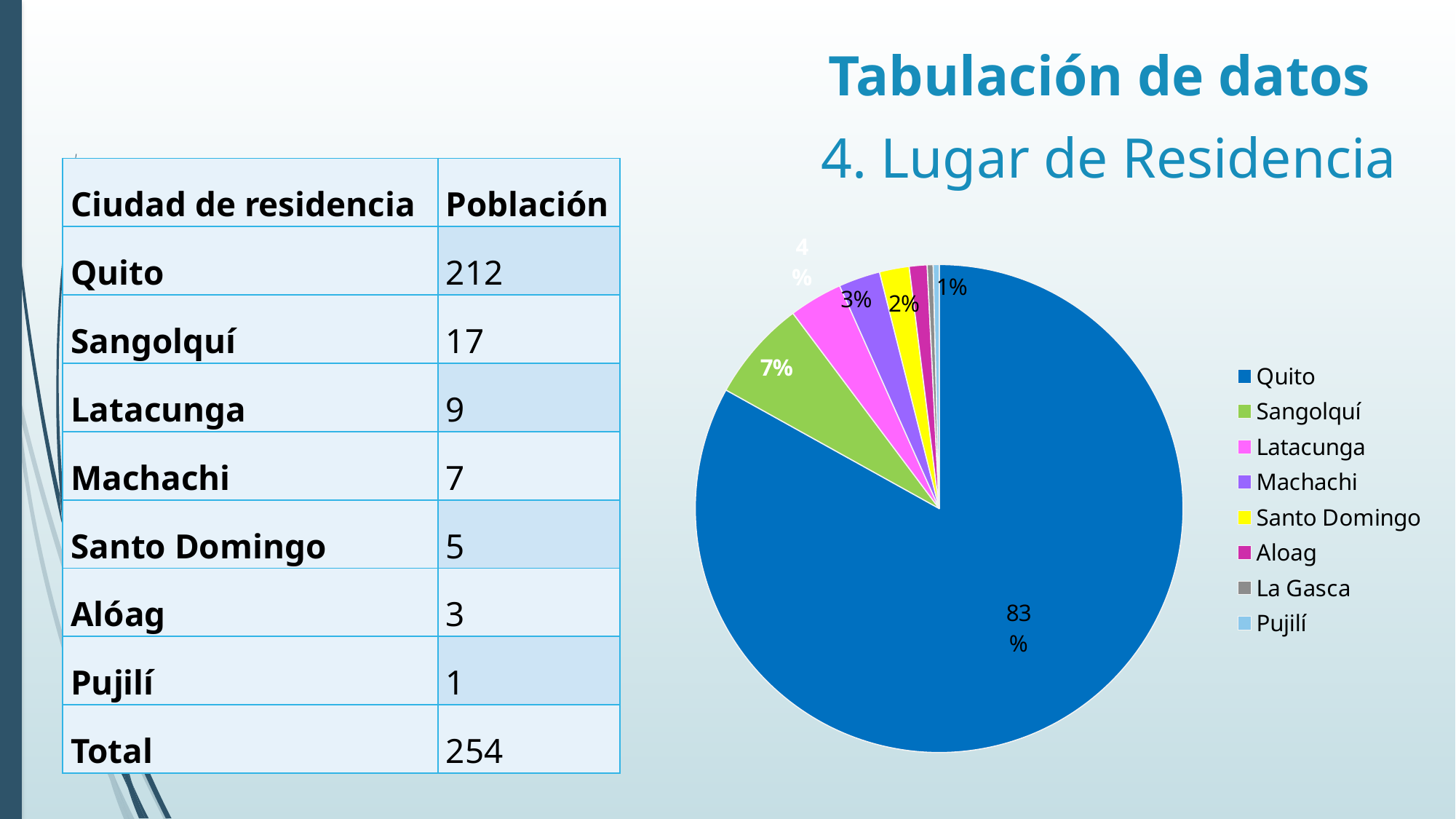
How many entries does the pie chart's legend list? 8 Which slice is larger in the pie chart, Sangolquí or Latacunga? Sangolquí What percentage is shown for Sangolquí in the pie chart? 7% What percentage is shown for Machachi in the pie chart? 3% What colour is the Santo Domingo slice in the pie chart? yellow What colour is the Quito slice in the pie chart? blue What kind of chart is shown on the slide? pie chart What percentage is shown for Quito in the pie chart? 83% What percentage is shown for Santo Domingo in the pie chart? 2% What is the difference in percentage points between the Quito slice and the Sangolquí slice? 76% Which slice is larger in the pie chart, Machachi or Santo Domingo? Machachi Which city has the largest slice in the pie chart? Quito